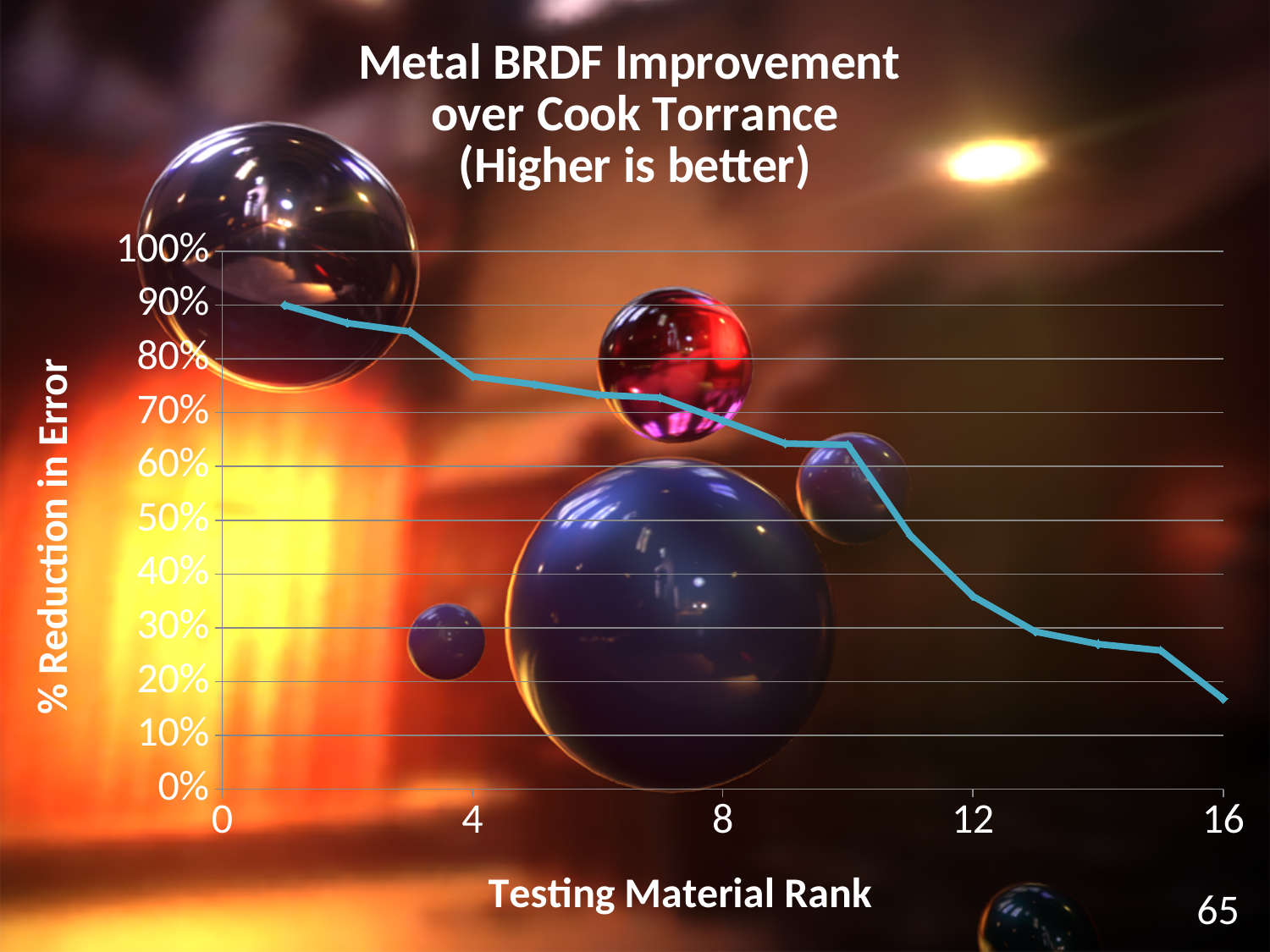
What is the label of the y axis? % Reduction in Error Is the value at Testing Material Rank 1 greater or less than 80%? greater Is the value at Testing Material Rank 16 greater or less than 20%? less Is the value at Testing Material Rank 12 greater or less than 40%? less What kind of chart is shown on the slide? line chart Do the values rise or fall as Testing Material Rank increases along the x axis? fall At which Testing Material Rank is the % Reduction in Error lowest? 16 What is the title of the chart? Metal BRDF Improvement over Cook Torrance (Higher is better) At which Testing Material Rank is the % Reduction in Error highest? 1 Which has the larger % Reduction in Error, Testing Material Rank 4 or Rank 12? Rank 4